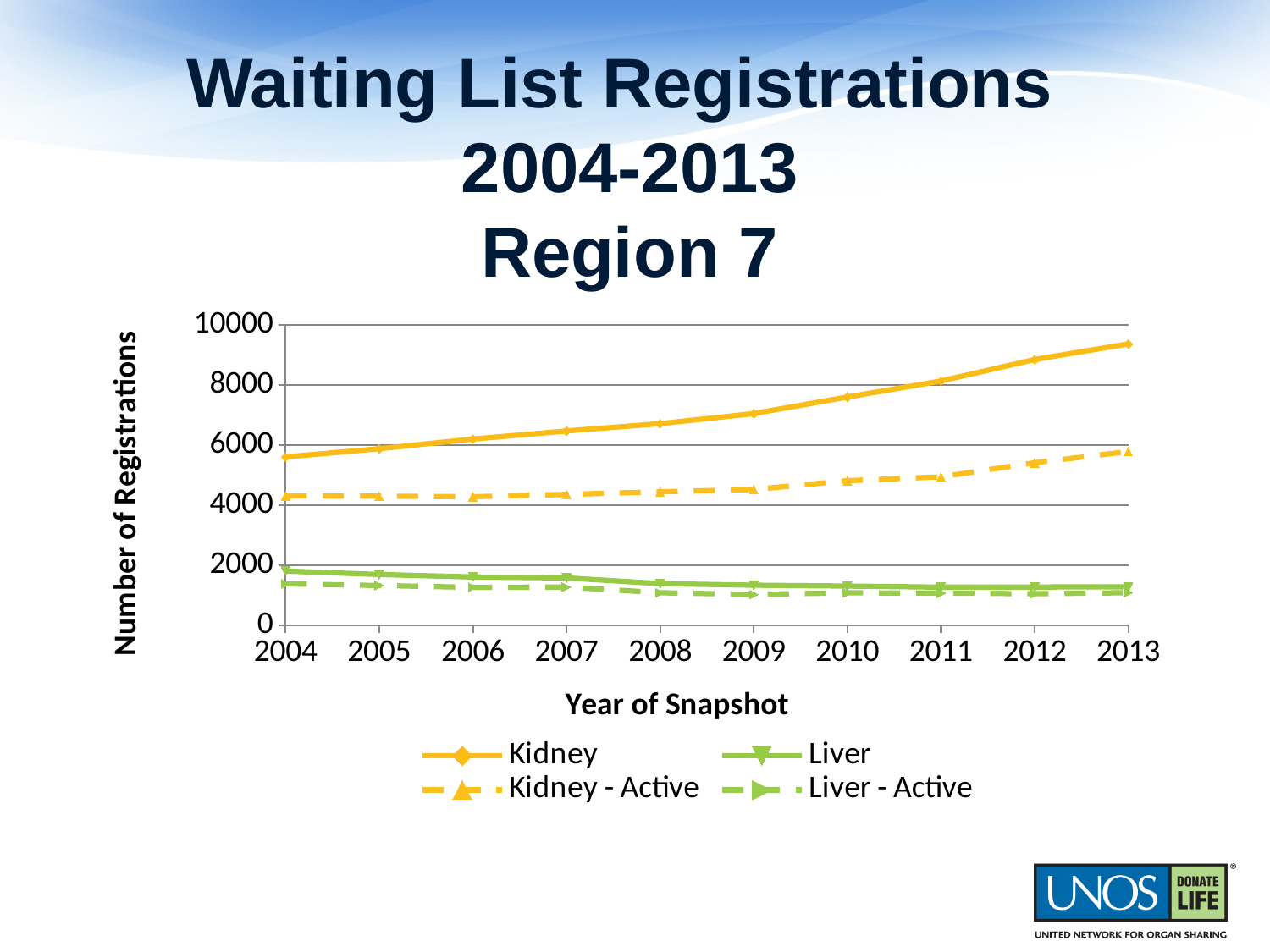
How many years are plotted along the x axis? 10 Is the value for Liver - Active in 2013 greater or less than 2000? less Do the Kidney registrations rise or fall from 2004 to 2013? rise Is the value for Kidney in 2013 greater or less than 8000? greater What is the title of the x axis? Year of Snapshot Do the Liver registrations rise or fall from 2004 to 2013? fall How many series does the legend list? 4 What kind of chart is shown on the slide? line chart In which year is the Kidney series at its highest? 2013 Which is larger in 2010, Kidney or Liver? Kidney Which series has the highest value in 2013? Kidney Is the value for Kidney in 2004 greater or less than 6000? less